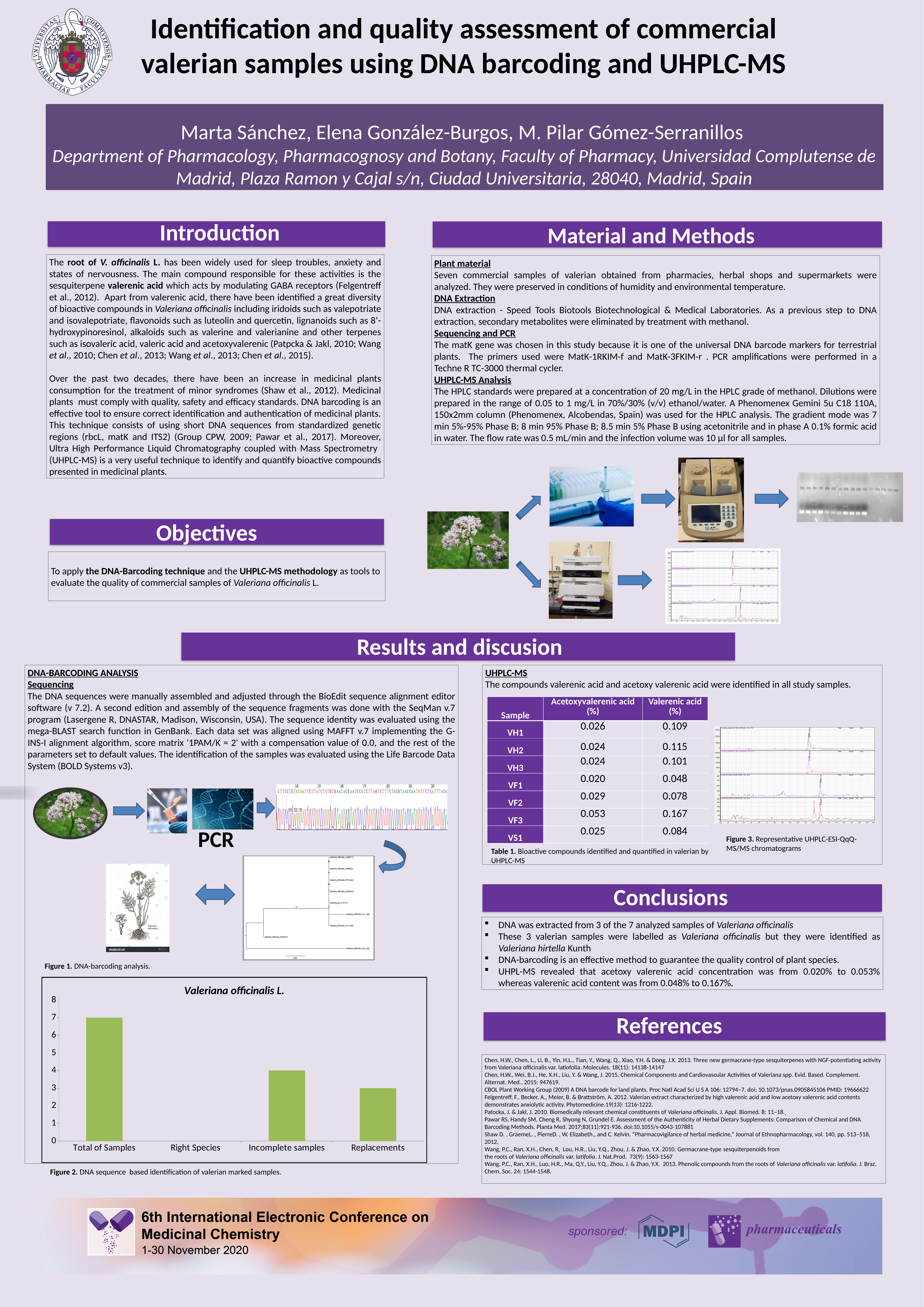
In the 'Valeriana officinalis L.' bar chart, is the value for Total of Samples greater or less than 6? greater What is the title of the bar chart at the bottom left of the slide? Valeriana officinalis L. In the 'Valeriana officinalis L.' bar chart, what is the value for Replacements? 3 In the 'Valeriana officinalis L.' bar chart, what is the value for Total of Samples? 7 In the 'Valeriana officinalis L.' bar chart, which is larger, Incomplete samples or Replacements? Incomplete samples In the 'Valeriana officinalis L.' bar chart, which category has the highest value? Total of Samples What is the maximum value shown on the y axis of the 'Valeriana officinalis L.' bar chart? 8 In the 'Valeriana officinalis L.' bar chart, what is the difference between Total of Samples and Incomplete samples? 3 What kind of chart is the 'Valeriana officinalis L.' chart? bar chart In the 'Valeriana officinalis L.' bar chart, which category has the lowest value? Right Species In the 'Valeriana officinalis L.' bar chart, what is the value for Incomplete samples? 4 How many categories are shown on the x axis of the 'Valeriana officinalis L.' bar chart? 4